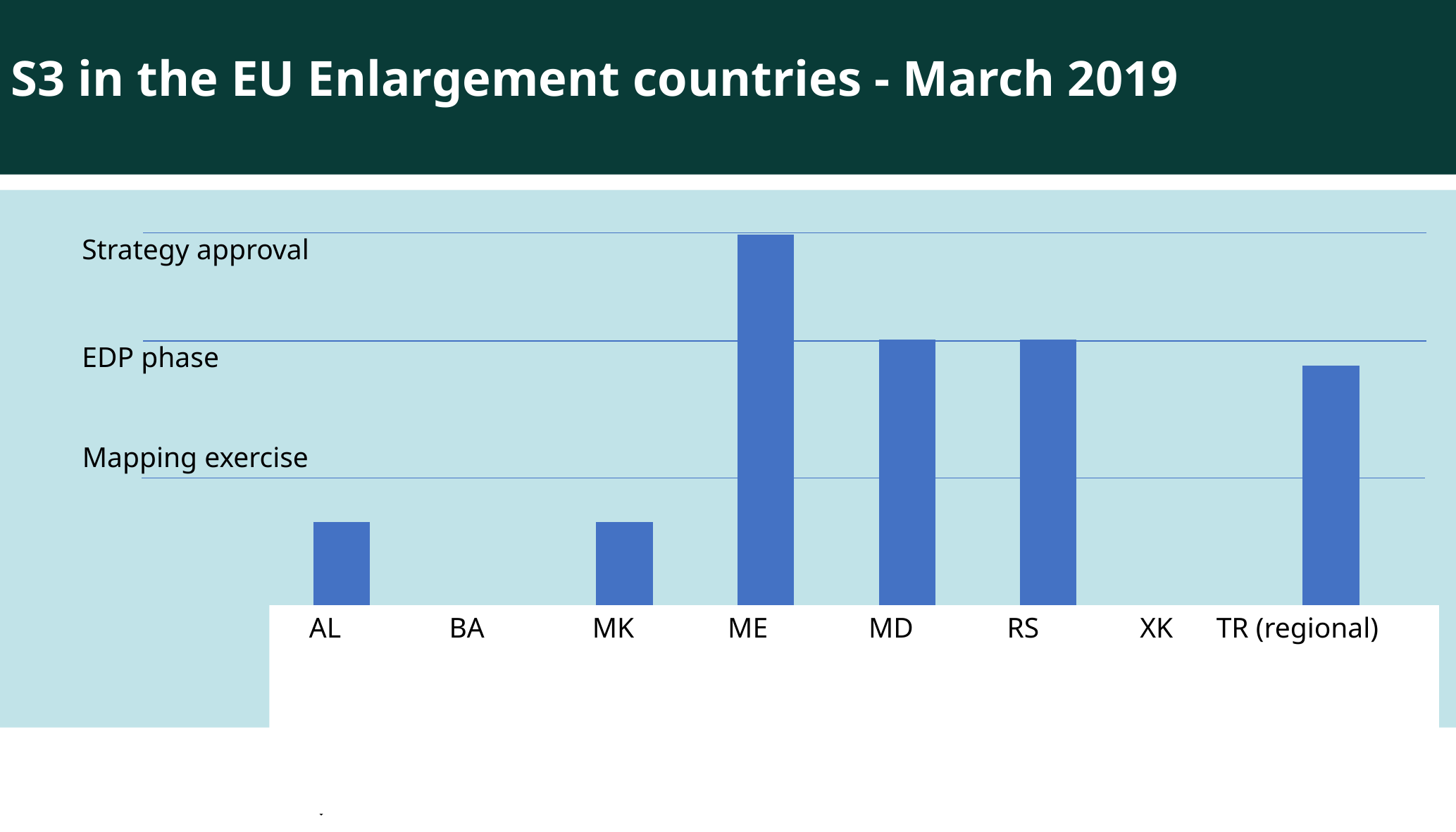
Which countries have no bar at all in the chart? BA and XK Is the bar for MK above or below the Mapping exercise line? below Which bar is taller, ME or MD? ME What kind of chart is shown on the slide? Bar chart Which country has the tallest bar in the chart? ME What is the title of the slide containing the chart? S3 in the EU Enlargement countries - March 2019 Is the bar for TR (regional) above or below the EDP phase line? below Which stage label do the bars for MD and RS reach on the y axis? EDP phase Which bar is taller, RS or TR (regional)? RS How many countries are listed along the x axis of the chart? 8 Which stage label does the bar for ME reach on the y axis? Strategy approval Is the bar for AL above or below the Mapping exercise line? below